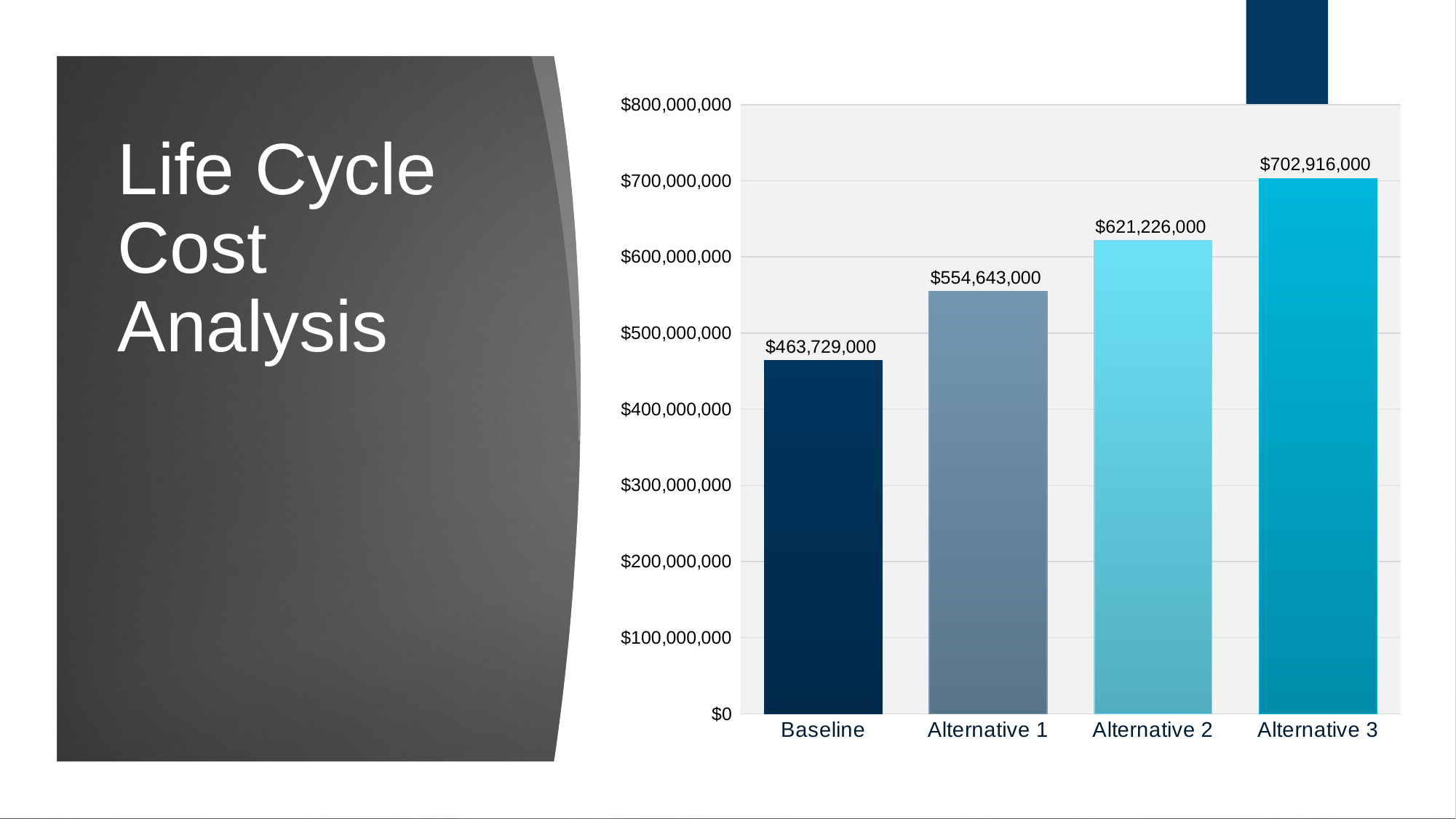
What is the difference between Alternative 2 and Alternative 1? $66,583,000 Which category has the lowest value? Baseline What is the difference between Alternative 3 and Baseline? $239,187,000 What is the value for Baseline? $463,729,000 What kind of chart is shown on the slide? bar chart Which category has the highest value? Alternative 3 What is the value for Alternative 3? $702,916,000 How many categories are shown on the x axis? 4 What is the value for Alternative 2? $621,226,000 What is the value for Alternative 1? $554,643,000 Is the value for Alternative 3 greater or less than $600,000,000? greater Which is larger, Alternative 1 or Alternative 2? Alternative 2